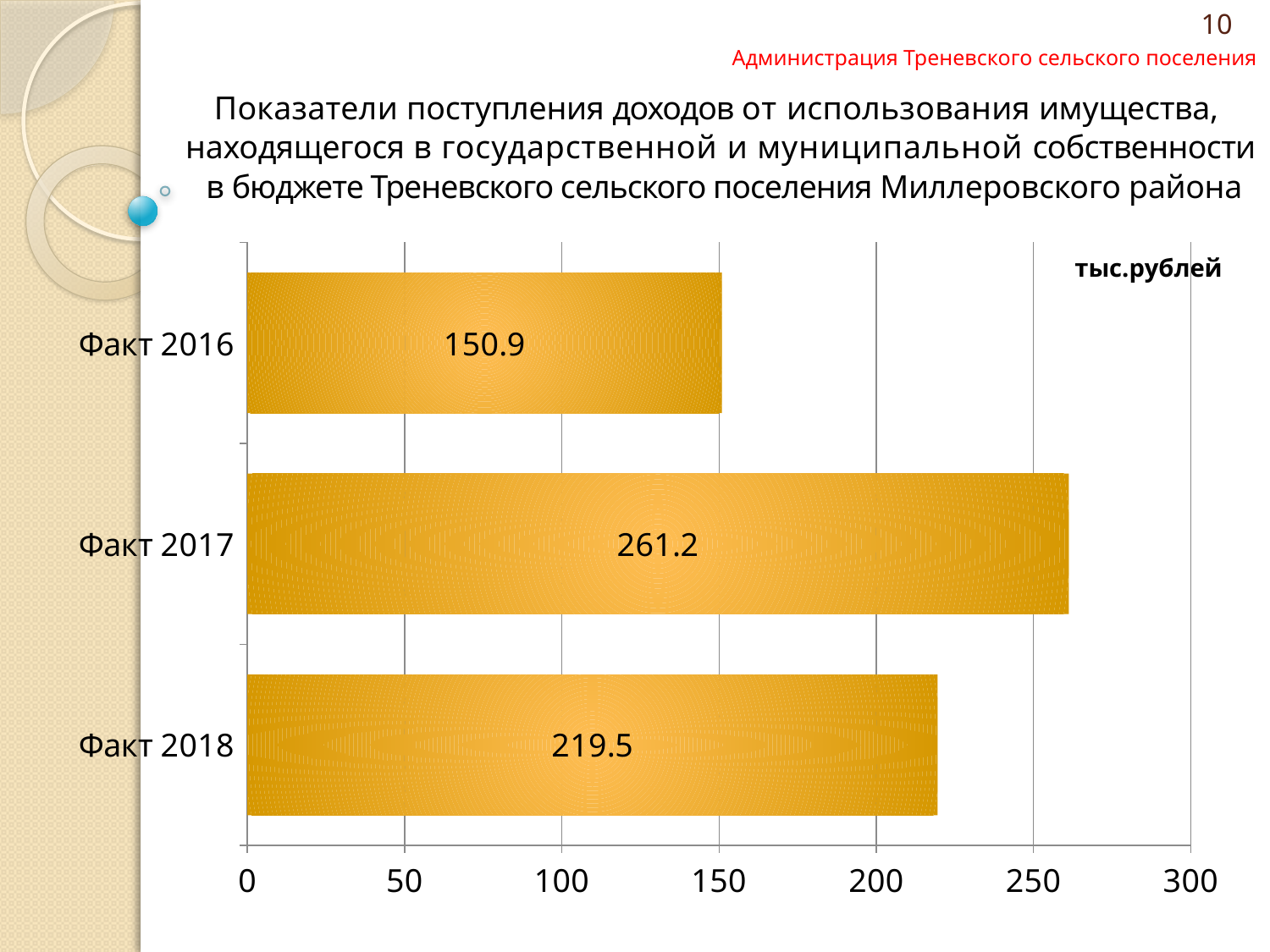
What is the value for Факт 2016? 150.9 What is the difference between the values for Факт 2017 and Факт 2016? 110.3 What is the difference between the values for Факт 2017 and Факт 2018? 41.7 What is the value for Факт 2017? 261.2 How many categories are shown in the chart? 3 Is the value for Факт 2018 greater or less than 200? greater Which category has the lowest value? Факт 2016 Which is larger, the value for Факт 2018 or the value for Факт 2016? Факт 2018 Which category has the highest value? Факт 2017 What unit is indicated for the values in the chart? тыс.рублей What kind of chart is shown on the slide? bar chart What is the value for Факт 2018? 219.5